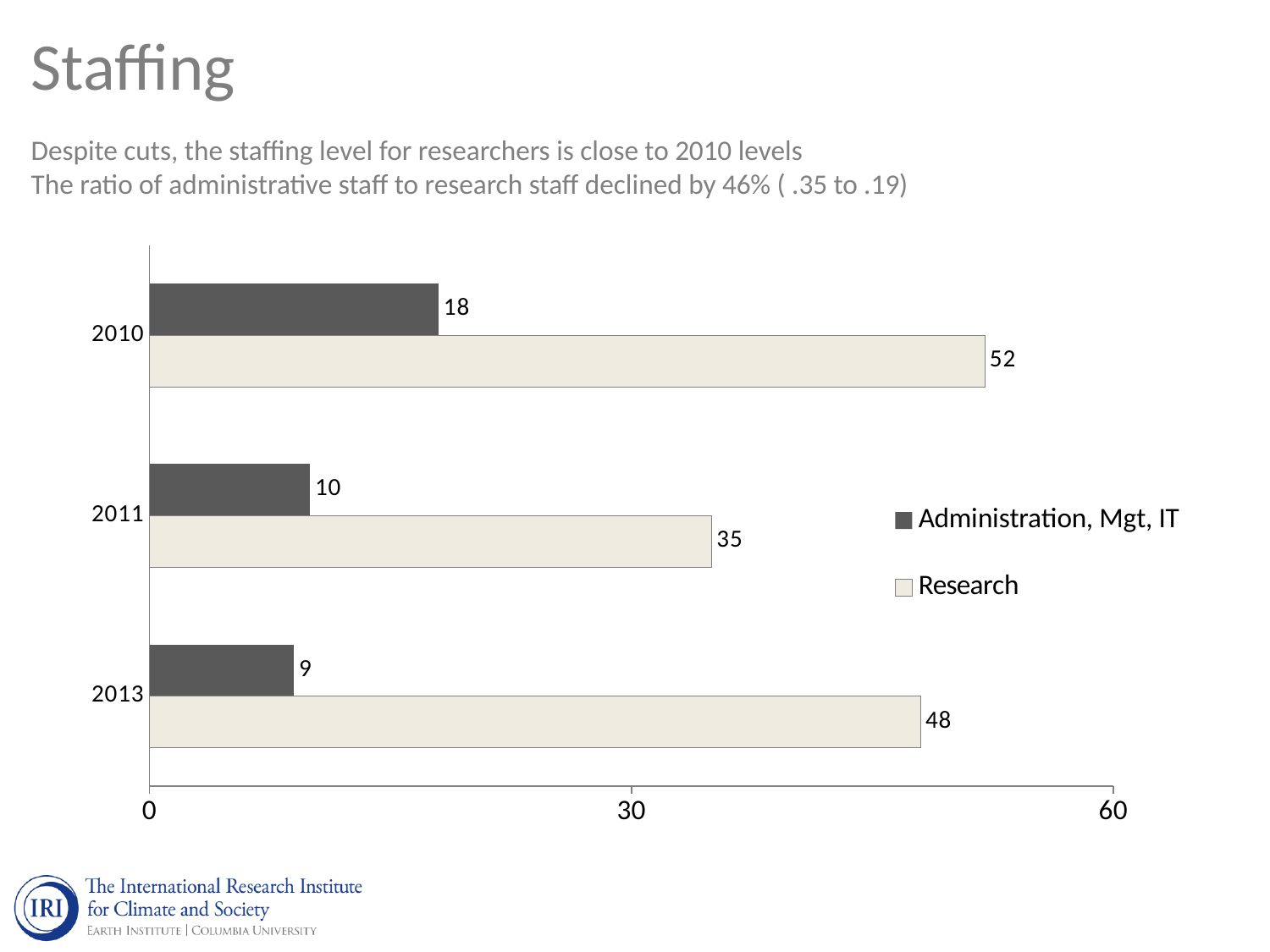
Which year has the lowest Administration, Mgt, IT value? 2013 Which is larger, the Research value for 2011 or the Research value for 2013? 2013 What is the Research value for 2013? 48 What is the Research staffing value for 2010? 52 How many series does the legend list? 2 Which year has the highest Research value? 2010 What kind of chart is shown on the slide? Bar chart What is the Administration, Mgt, IT value for 2013? 9 What is the difference between the Administration, Mgt, IT values for 2010 and 2013? 9 What is the difference between the Research values for 2010 and 2011? 17 How many years are shown on the chart? 3 What is the Administration, Mgt, IT value for 2011? 10